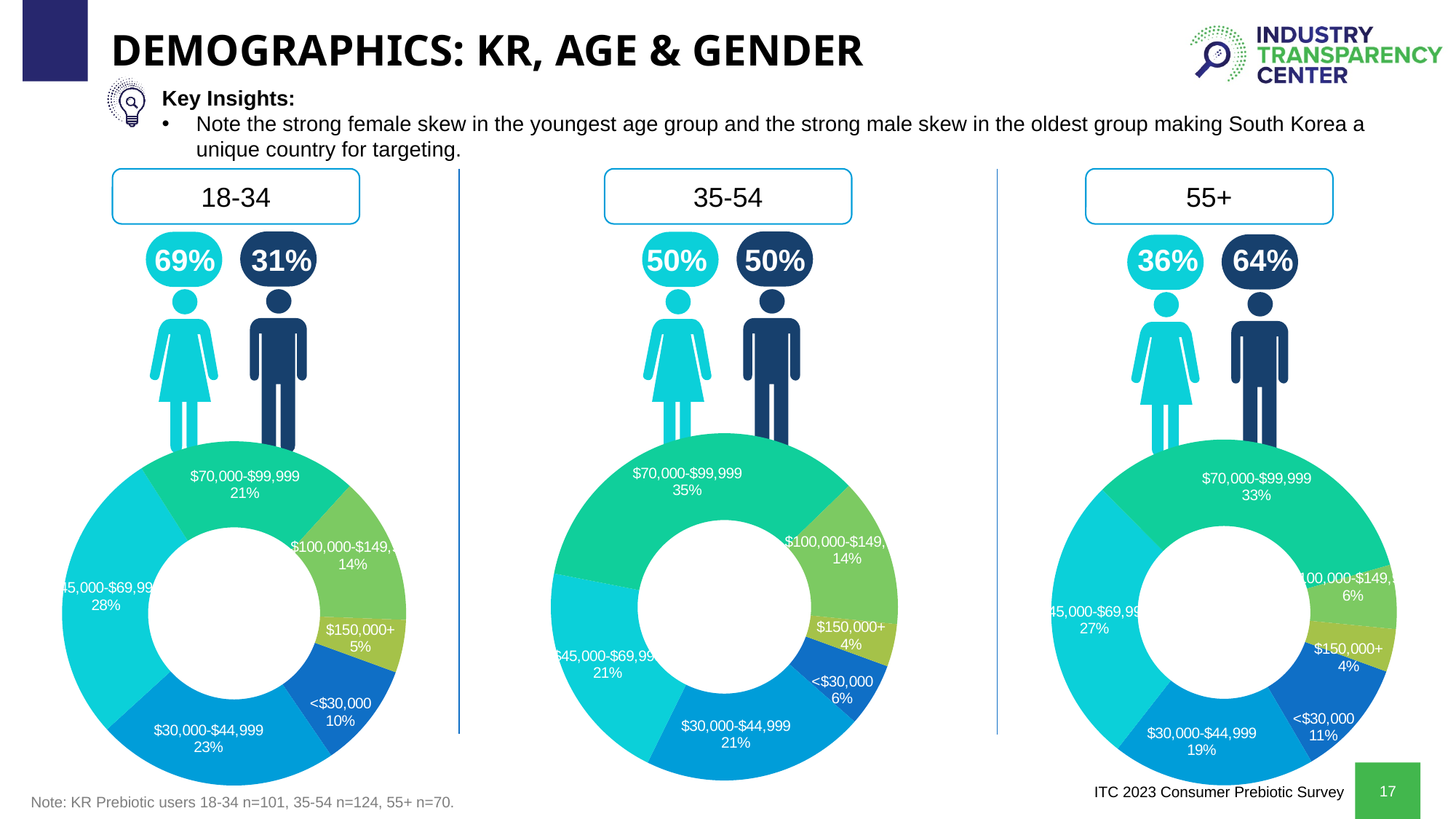
What percentage of the 55+ age group is male according to the slide? 64% In the 18-34 donut chart, what share is the $45,000-$69,999 income bracket? 28% In the 55+ donut chart, what share is the <$30,000 income bracket? 11% How many income brackets are shown in the 35-54 donut chart? 6 In the 55+ donut chart, which income bracket has the smallest share? $150,000+ In the 55+ donut chart, which is larger: the $30,000-$44,999 share or the $100,000-$149,999 share? $30,000-$44,999 In the 35-54 donut chart, what is the difference between the $70,000-$99,999 share and the $150,000+ share? 31% In the 18-34 donut chart, what is the difference between the $30,000-$44,999 share and the <$30,000 share? 13% In the 18-34 donut chart, which income bracket has the largest share? $45,000-$69,999 In the 35-54 donut chart, what share is the $70,000-$99,999 income bracket? 35% What type of chart is used to show income brackets for each age group? Donut chart In the 35-54 donut chart, which income bracket has the largest share? $70,000-$99,999